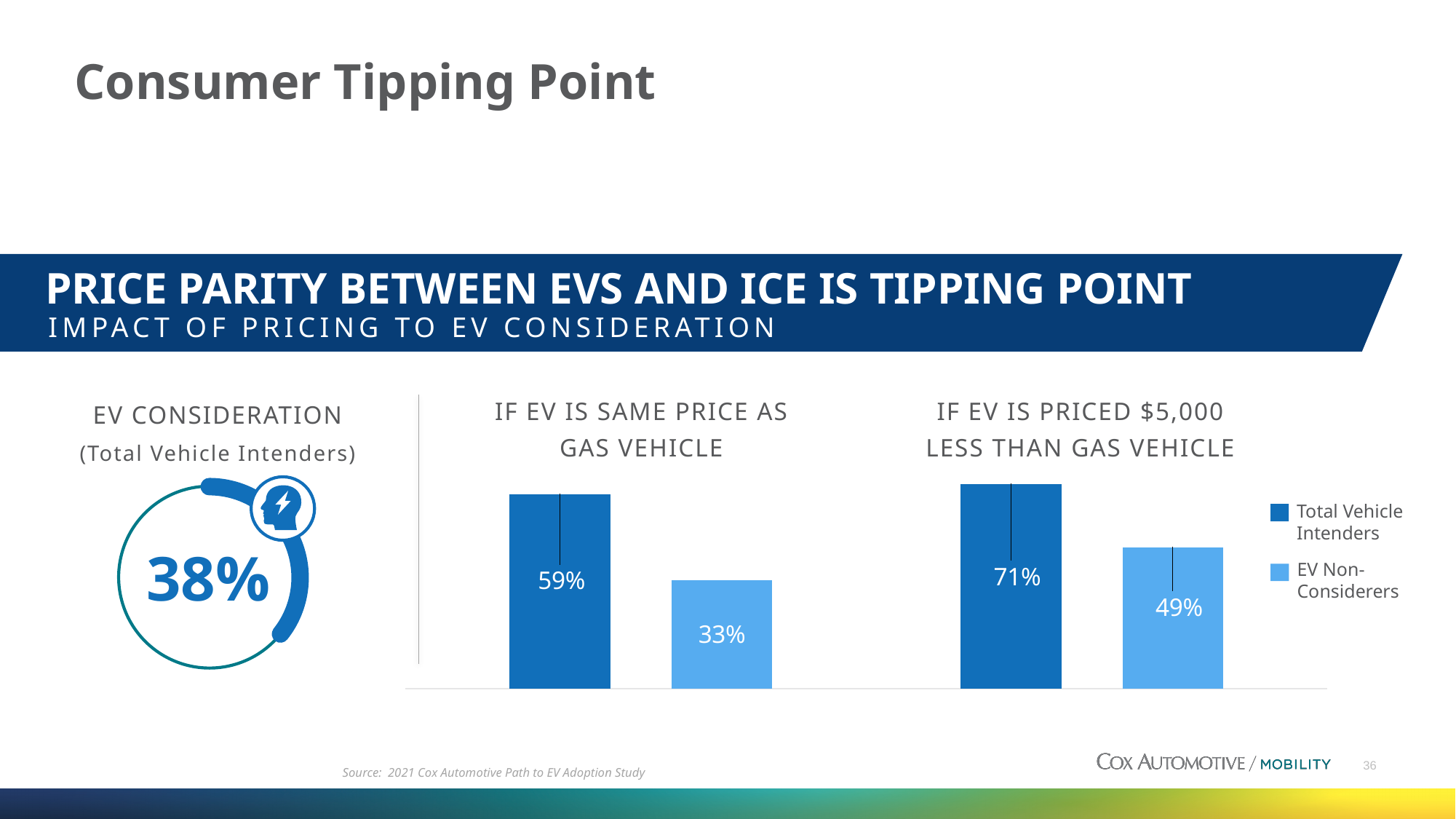
How many series does the chart legend list? 2 What percentage of EV Non-Considerers would consider an EV if it is the same price as a gas vehicle? 33% Which bar in the chart has the highest value? Total Vehicle Intenders, if EV is priced $5,000 less than gas vehicle (71%) What percentage of EV Non-Considerers would consider an EV if it is priced $5,000 less than a gas vehicle? 49% What percentage of Total Vehicle Intenders would consider an EV if it is priced $5,000 less than a gas vehicle? 71% Which bar in the chart has the lowest value? EV Non-Considerers, if EV is same price as gas vehicle (33%) What is the difference between Total Vehicle Intenders and EV Non-Considerers when the EV is the same price as a gas vehicle? 26 percentage points What percentage of Total Vehicle Intenders would consider an EV if it is the same price as a gas vehicle? 59% Which is larger: Total Vehicle Intenders at the same price as a gas vehicle, or EV Non-Considerers at $5,000 less than a gas vehicle? Total Vehicle Intenders at the same price (59%) By how many percentage points does EV Non-Considerers' consideration rise from the same-price scenario to the $5,000-less scenario? 16 percentage points What type of chart is used to show the impact of pricing on EV consideration? Bar chart What is the EV consideration percentage shown for Total Vehicle Intenders in the circle graphic on the left? 38%